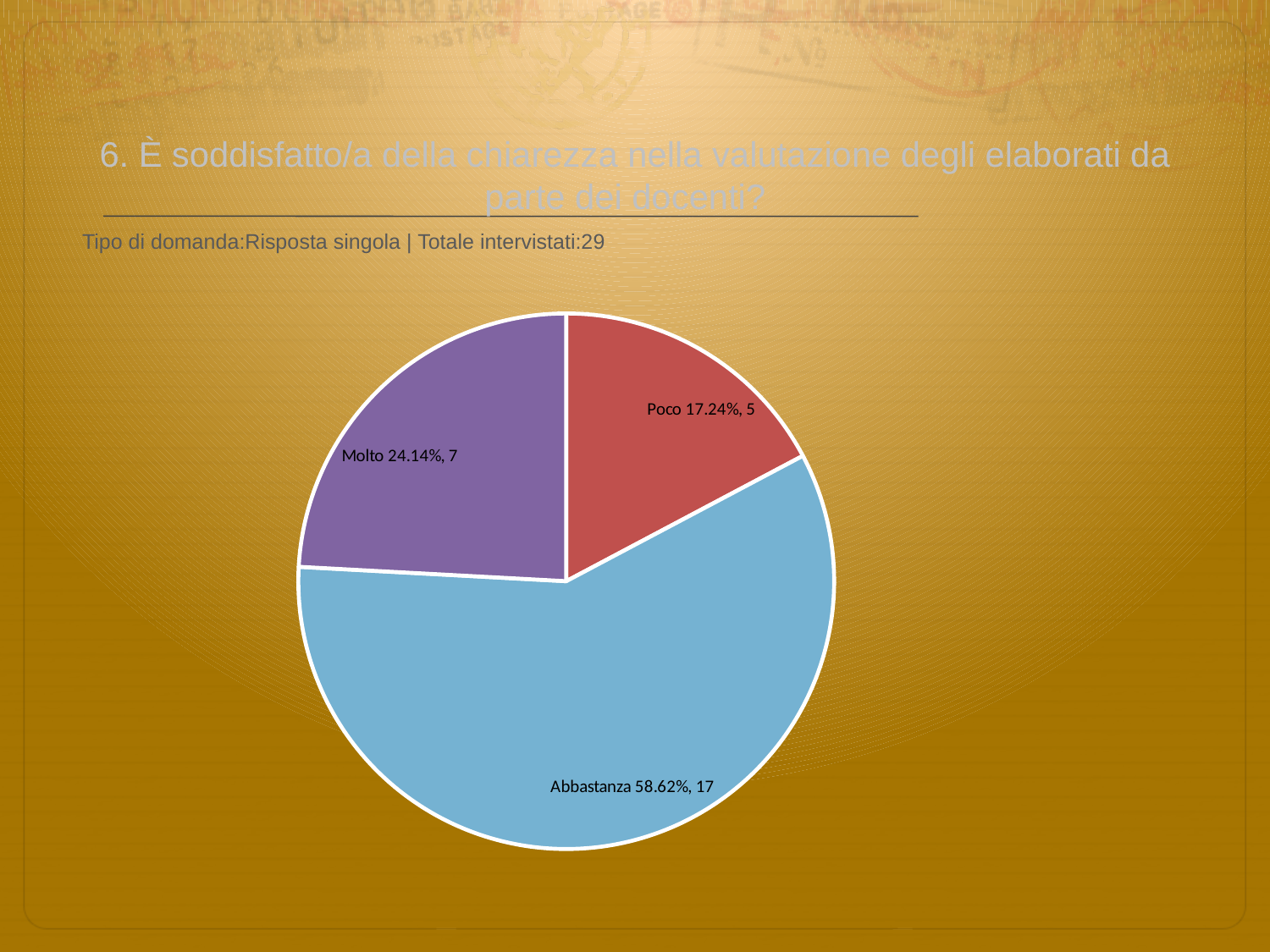
What kind of chart is shown on the slide? pie chart What percentage share does the Abbastanza slice have? 58.62% What percentage share does the Poco slice have? 17.24% How many respondents answered Abbastanza? 17 Which category has the largest slice? Abbastanza What percentage share does the Molto slice have? 24.14% How many respondents answered Molto? 7 What is the difference in respondent count between Abbastanza and Molto? 10 How many slices does the pie chart have? 3 How many respondents answered Poco? 5 Which slice is larger, Molto or Poco? Molto Which category has the smallest slice? Poco